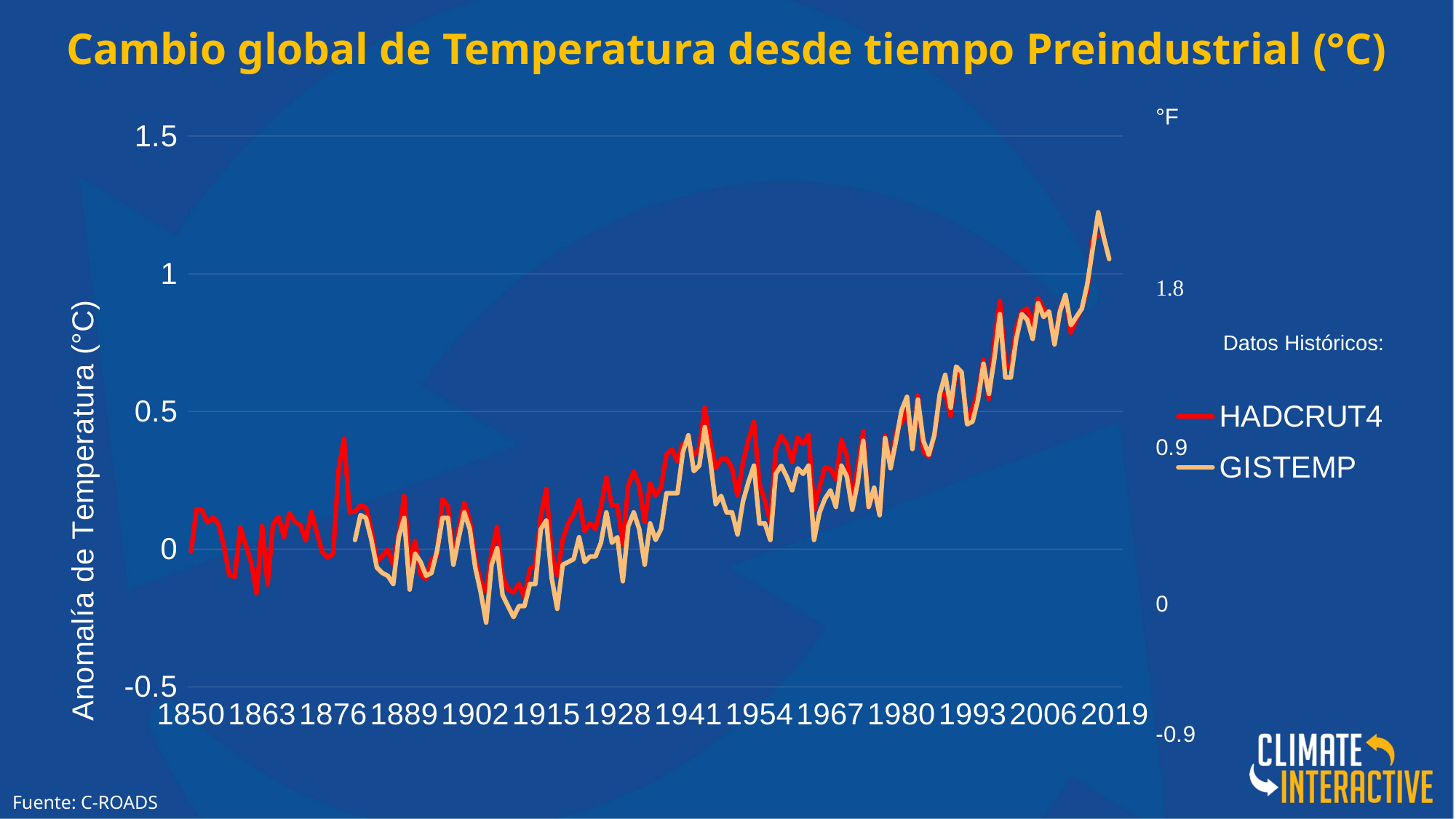
Overall, do the temperature anomaly values rise or fall from 1850 to 2019? rise Is the GISTEMP value around 1993 greater or less than 1? less Which two series are listed in the legend under 'Datos Históricos'? HADCRUT4 and GISTEMP Is the highest GISTEMP value (around 2016) greater or less than 1? greater What kind of chart is shown on the slide? line chart Is the HADCRUT4 value around 1941 greater or less than 0? greater What is the title of the chart? Cambio global de Temperatura desde tiempo Preindustrial (°C) How many series does the legend list? 2